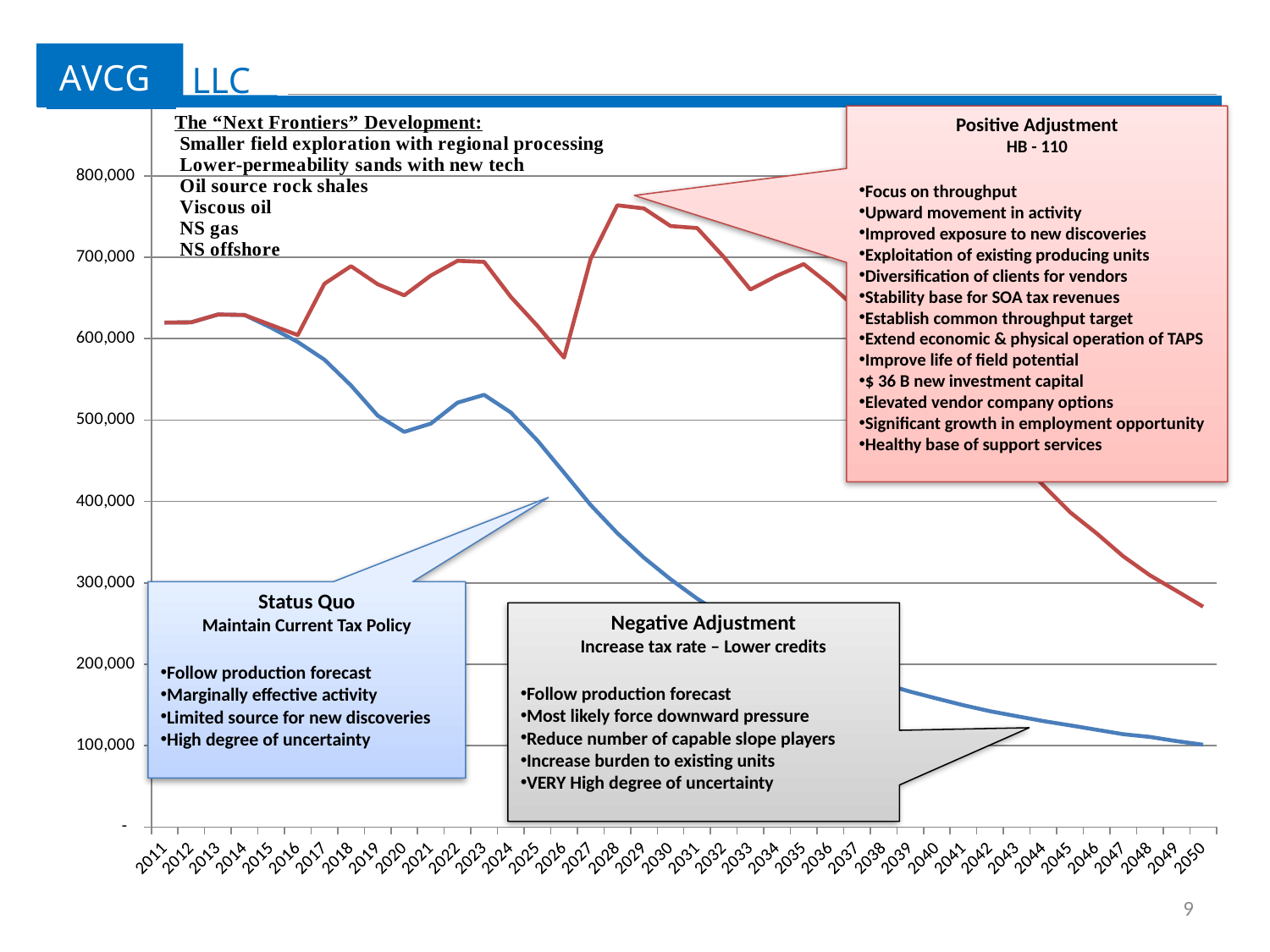
What is the first year shown on the x axis? 2011 What kind of chart is shown on the slide? line chart What is the last year shown on the x axis? 2050 Is the value of the red line in 2028 greater or less than 700,000? greater Is the value of the red line in 2026 greater or less than 600,000? less In 2030, which line has the higher value, the red line or the blue line? the red line Does the blue line rise or fall between 2016 and 2050? fall Is the value of the red line in 2050 greater or less than 300,000? less Which colour is the line that the "Positive Adjustment HB - 110" callout points to? red How many years are labelled along the x axis of the chart? 40